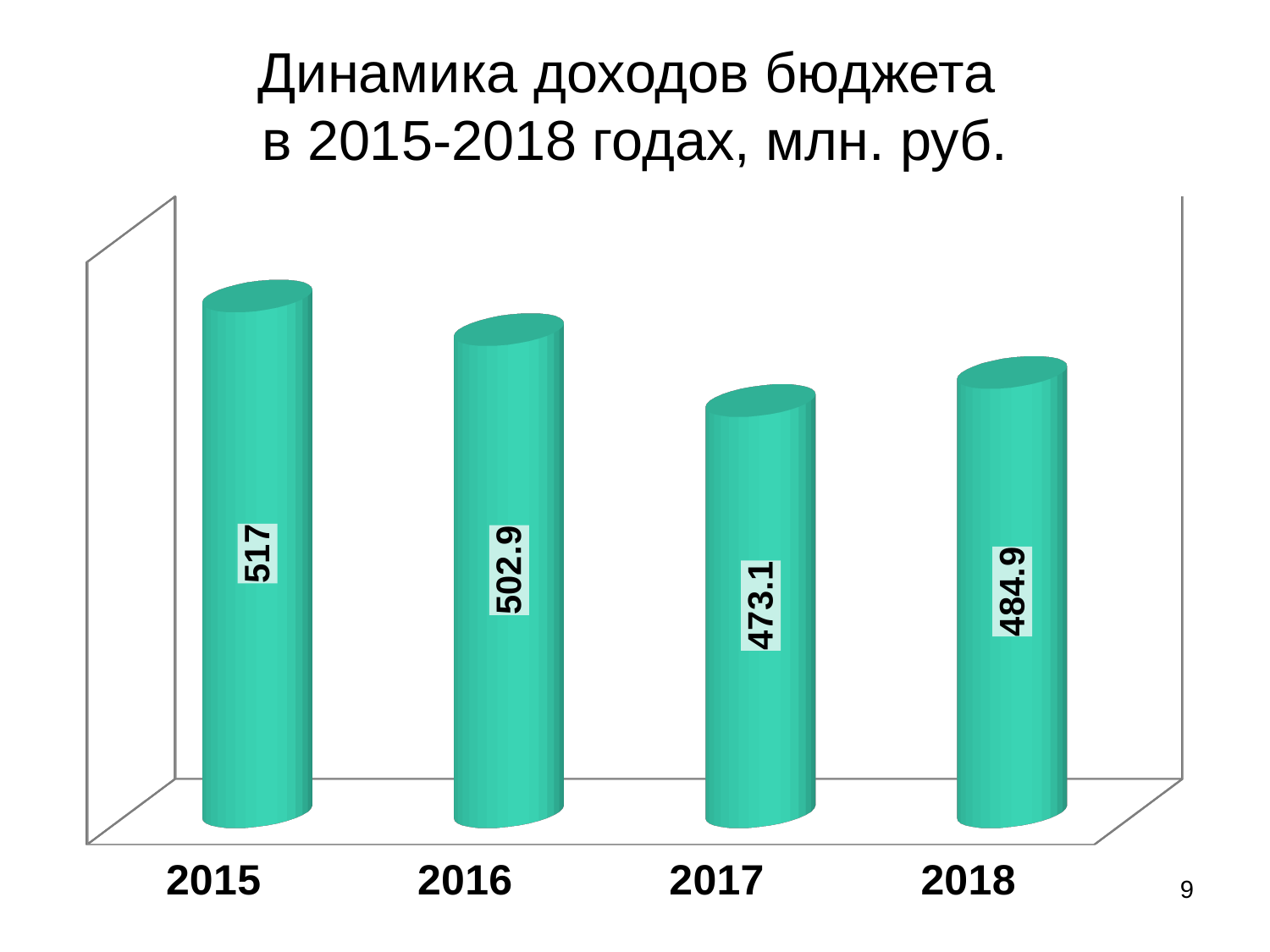
Which year has the highest budget revenue? 2015 Which year has a larger budget revenue, 2016 or 2018? 2016 What is the title of the chart? Динамика доходов бюджета в 2015-2018 годах, млн. руб. What is the budget revenue value for 2018? 484.9 What is the difference between the budget revenue in 2015 and 2016? 14.1 Which year has the lowest budget revenue? 2017 What is the budget revenue value for 2015? 517 What is the budget revenue value for 2016? 502.9 What kind of chart is shown on the slide? Bar chart What is the difference between the budget revenue in 2018 and 2017? 11.8 What is the budget revenue value for 2017? 473.1 How many years are shown on the chart? 4